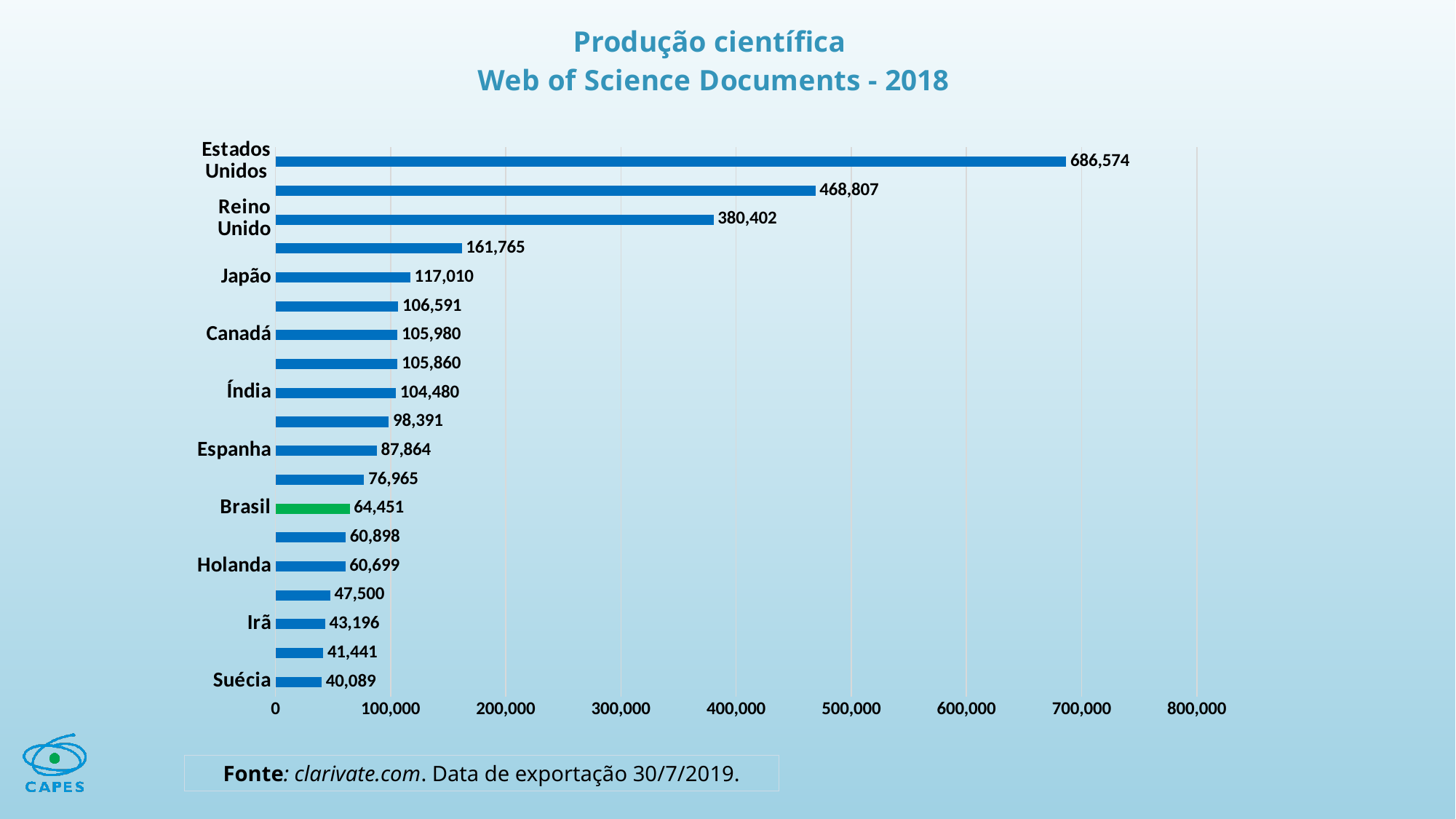
What kind of chart is shown on the slide? Bar chart Which country has the highest number of Web of Science documents? Estados Unidos Which labelled country has the lowest value on the chart? Suécia How many bars are plotted on the chart? 19 What is the value for Canadá? 105,980 What is the value for Brasil? 64,451 Is the value for Reino Unido greater or less than 300,000? greater What is the difference between the values for Estados Unidos and Reino Unido? 306,172 What is the value for Japão? 117,010 What is the value for Estados Unidos? 686,574 What is the difference between the values for Brasil and Holanda? 3,752 Which is larger, the value for Índia or the value for Espanha? Índia